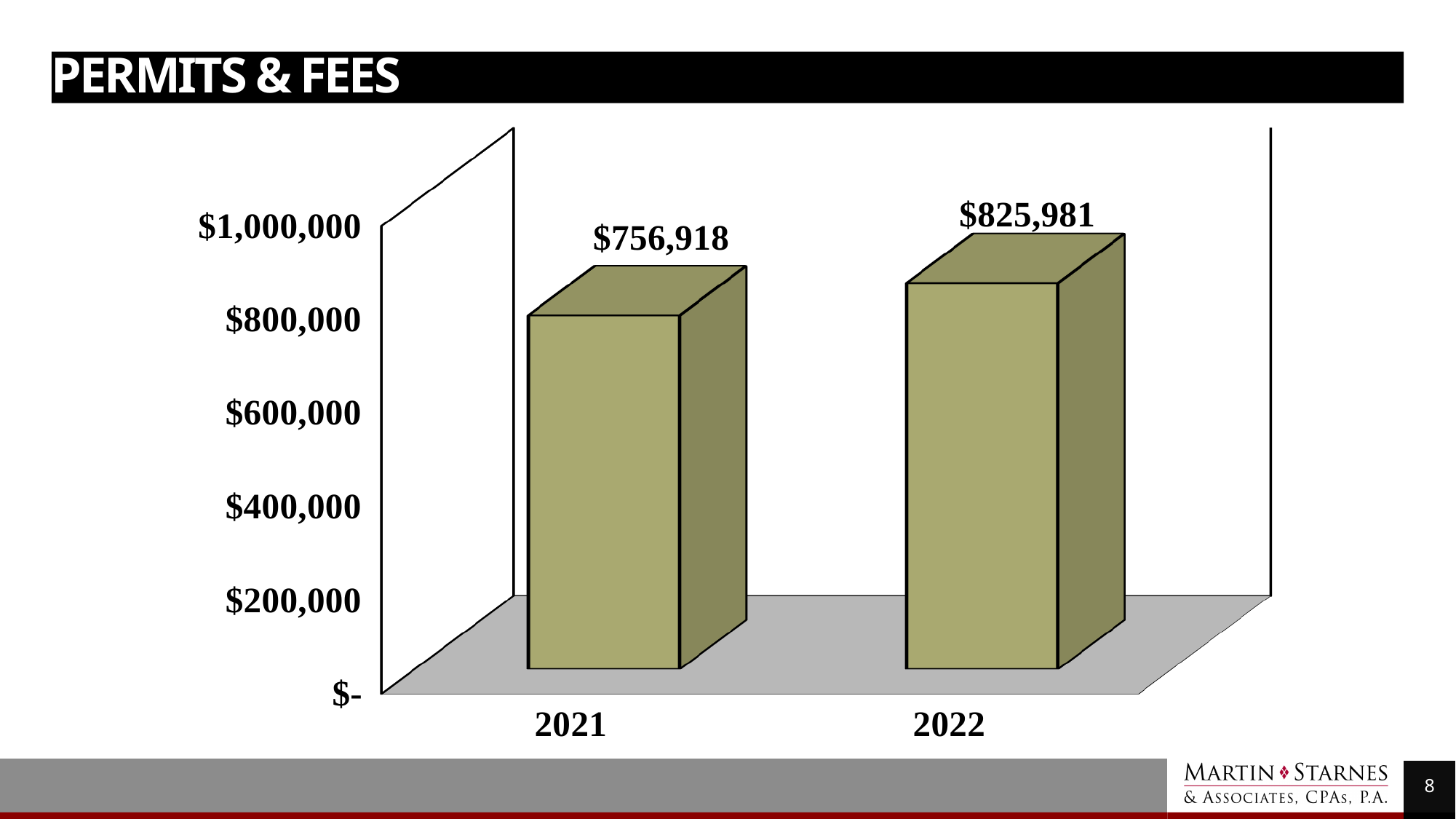
Which is larger, the value for 2021 or the value for 2022? 2022 What is the difference between the 2022 and 2021 values? $69,063 How many years are shown on the chart? 2 What is the value for 2021? $756,918 Which year has the highest value? 2022 Do the values rise or fall from 2021 to 2022? rise What is the title of the slide? PERMITS & FEES Is the value for 2021 greater or less than $800,000? less What is the value for 2022? $825,981 Is the value for 2022 greater or less than $800,000? greater Which year has the lowest value? 2021 What kind of chart is shown on the slide? bar chart